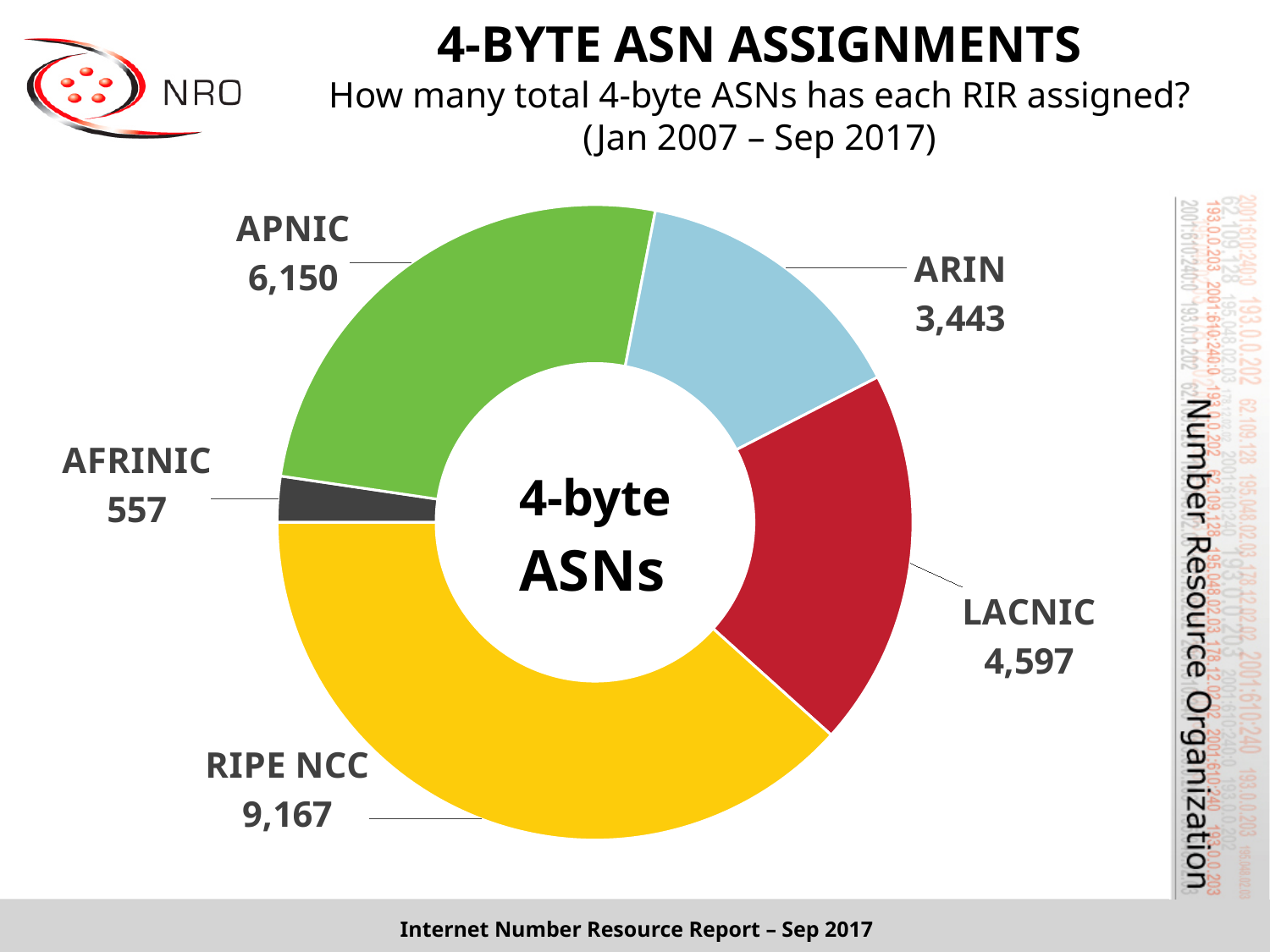
What is the value shown for ARIN? 3,443 What is the difference between the RIPE NCC and APNIC values? 3,017 Which has assigned more 4-byte ASNs, APNIC or LACNIC? APNIC What is the value shown for LACNIC? 4,597 Which RIR has assigned the most 4-byte ASNs? RIPE NCC What text is printed in the centre of the chart? 4-byte ASNs How many 4-byte ASNs has RIPE NCC assigned according to the chart? 9,167 What is the value shown for AFRINIC? 557 Which RIR has assigned the fewest 4-byte ASNs? AFRINIC What is the difference between the LACNIC and ARIN values? 1,154 How many RIRs are shown as segments in the chart? 5 What kind of chart is used on this slide? doughnut chart